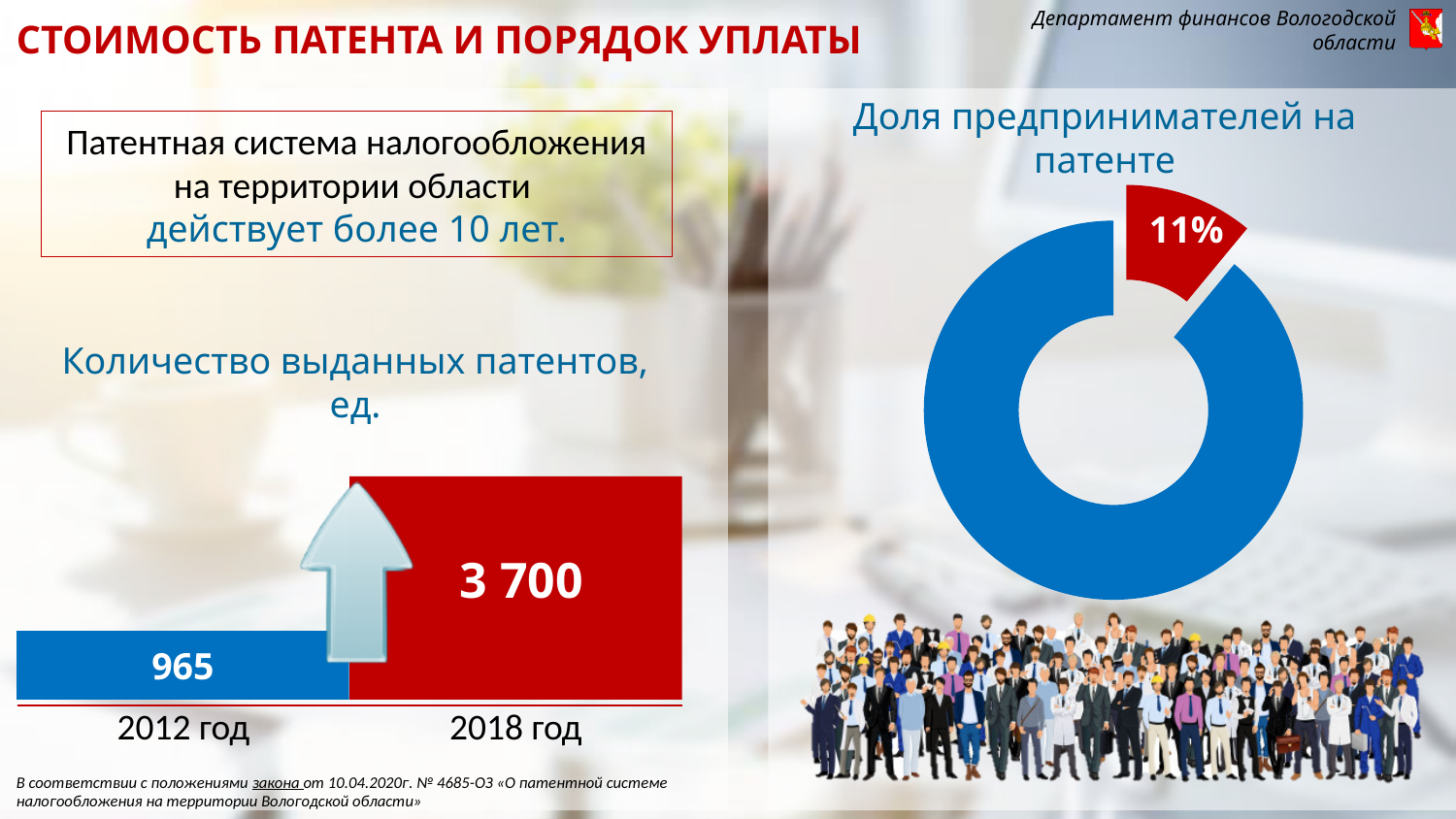
What kind of chart is 'Количество выданных патентов, ед.'? bar chart In the chart 'Количество выданных патентов, ед.', which year has the lower value? 2012 год In the chart 'Количество выданных патентов, ед.', what is the value for 2012 год? 965 In the chart 'Доля предпринимателей на патенте', what share is shown for the red slice? 11% In the chart 'Количество выданных патентов, ед.', which year has the higher value? 2018 год What kind of chart is 'Доля предпринимателей на патенте'? doughnut chart How many categories are shown in the chart 'Количество выданных патентов, ед.'? 2 In the chart 'Количество выданных патентов, ед.', what is the difference between the 2018 год and 2012 год values? 2 735 In the chart 'Доля предпринимателей на патенте', what colour is the slice labelled 11%? red In the chart 'Количество выданных патентов, ед.', what is the value for 2018 год? 3 700 In the chart 'Количество выданных патентов, ед.', is the value for 2012 год larger or smaller than the value for 2018 год? smaller In the chart 'Количество выданных патентов, ед.', do the values rise or fall from 2012 год to 2018 год? rise